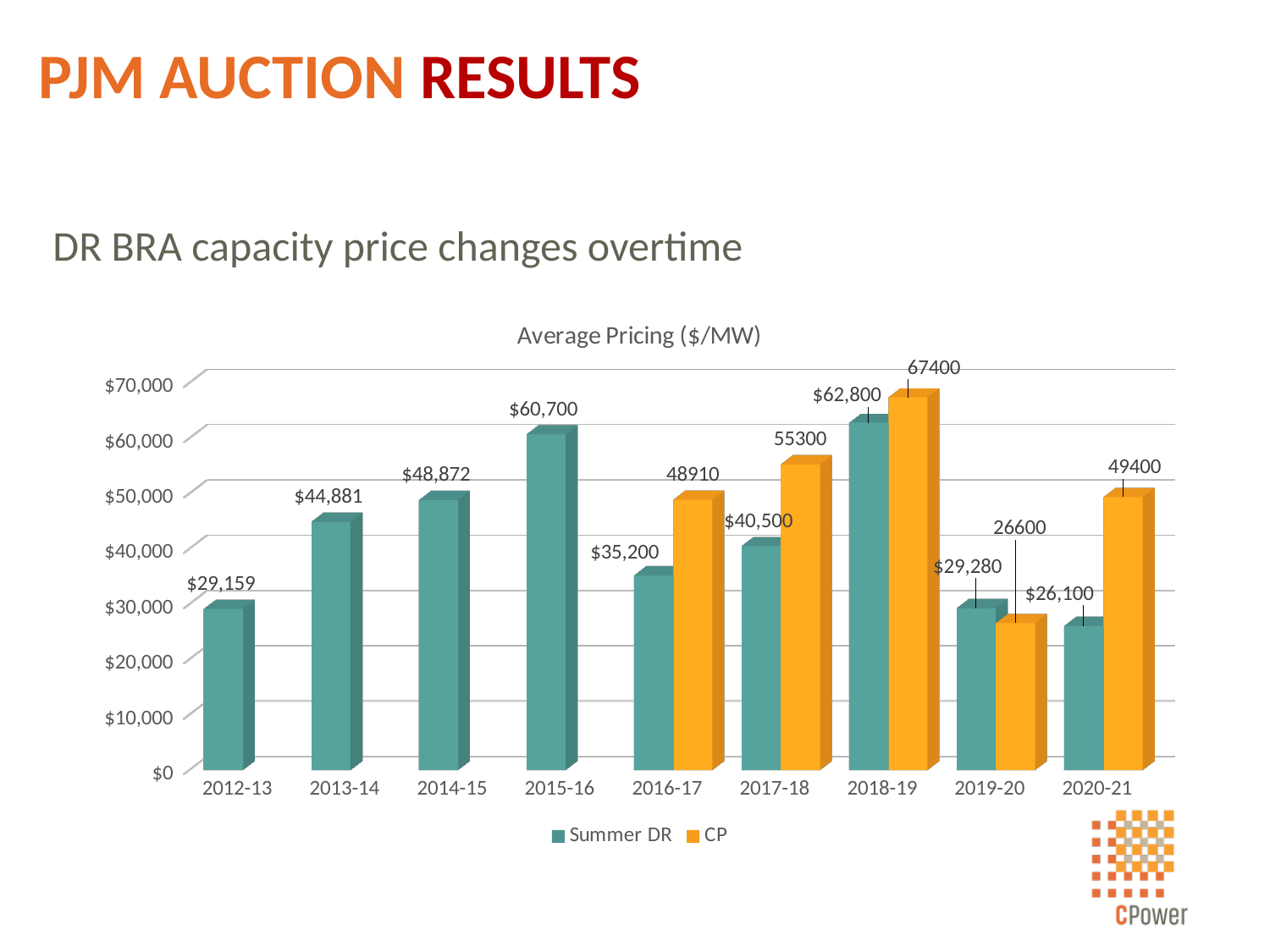
In 2019-20, which is larger, the Summer DR value or the CP value? Summer DR What is the Summer DR value for 2012-13? $29,159 How many years are shown on the x axis? 9 What is the CP value for 2018-19? 67400 How many series does the legend list? 2 Which year has the lowest CP value? 2019-20 What is the title of the chart? Average Pricing ($/MW) What is the difference between the CP value and the Summer DR value in 2017-18? 14800 What is the Summer DR value for 2015-16? $60,700 What is the CP value for 2019-20? 26600 What kind of chart is shown? Bar chart Which year has the highest Summer DR value? 2018-19